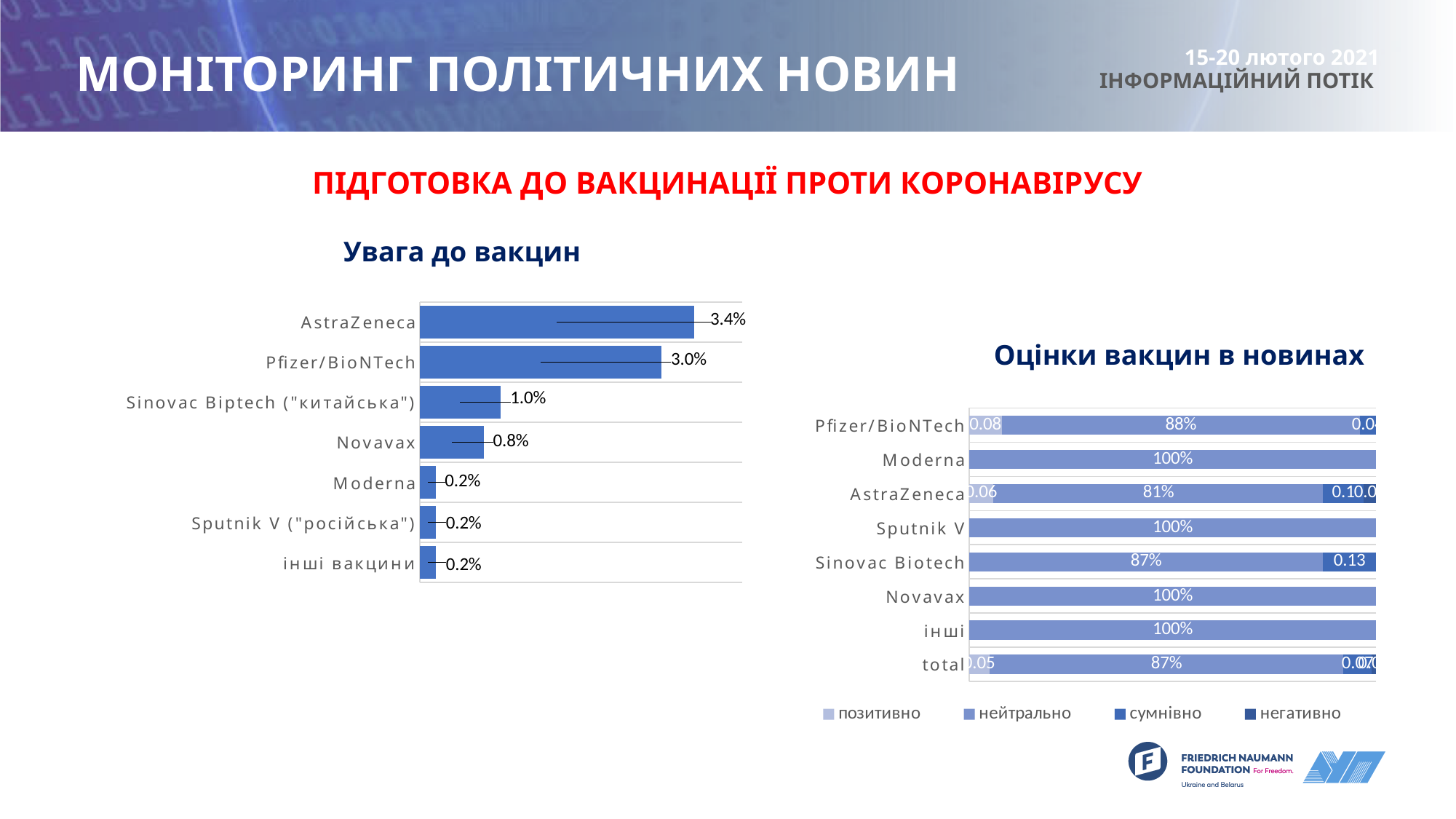
In the 'Оцінки вакцин в новинах' chart, what is the 'нейтрально' share for AstraZeneca? 81% How many categories are shown in the 'Увага до вакцин' chart? 7 What kind of chart is 'Увага до вакцин'? Bar chart In the 'Увага до вакцин' chart, what is the value for Novavax? 0.8% In the 'Увага до вакцин' chart, which category has the highest value? AstraZeneca In the 'Увага до вакцин' chart, which is larger: the value for Sinovac Biptech ("китайська") or the value for Novavax? Sinovac Biptech ("китайська") How many series does the legend of the 'Оцінки вакцин в новинах' chart list? 4 In the 'Увага до вакцин' chart, what is the value for AstraZeneca? 3.4% In the 'Оцінки вакцин в новинах' chart, what is the 'нейтрально' share for Sinovac Biotech? 87% In the 'Увага до вакцин' chart, what is the difference between the values for AstraZeneca and Pfizer/BioNTech? 0.4% How many categories are shown in the 'Оцінки вакцин в новинах' chart? 8 In the 'Увага до вакцин' chart, what is the value for Pfizer/BioNTech? 3.0%